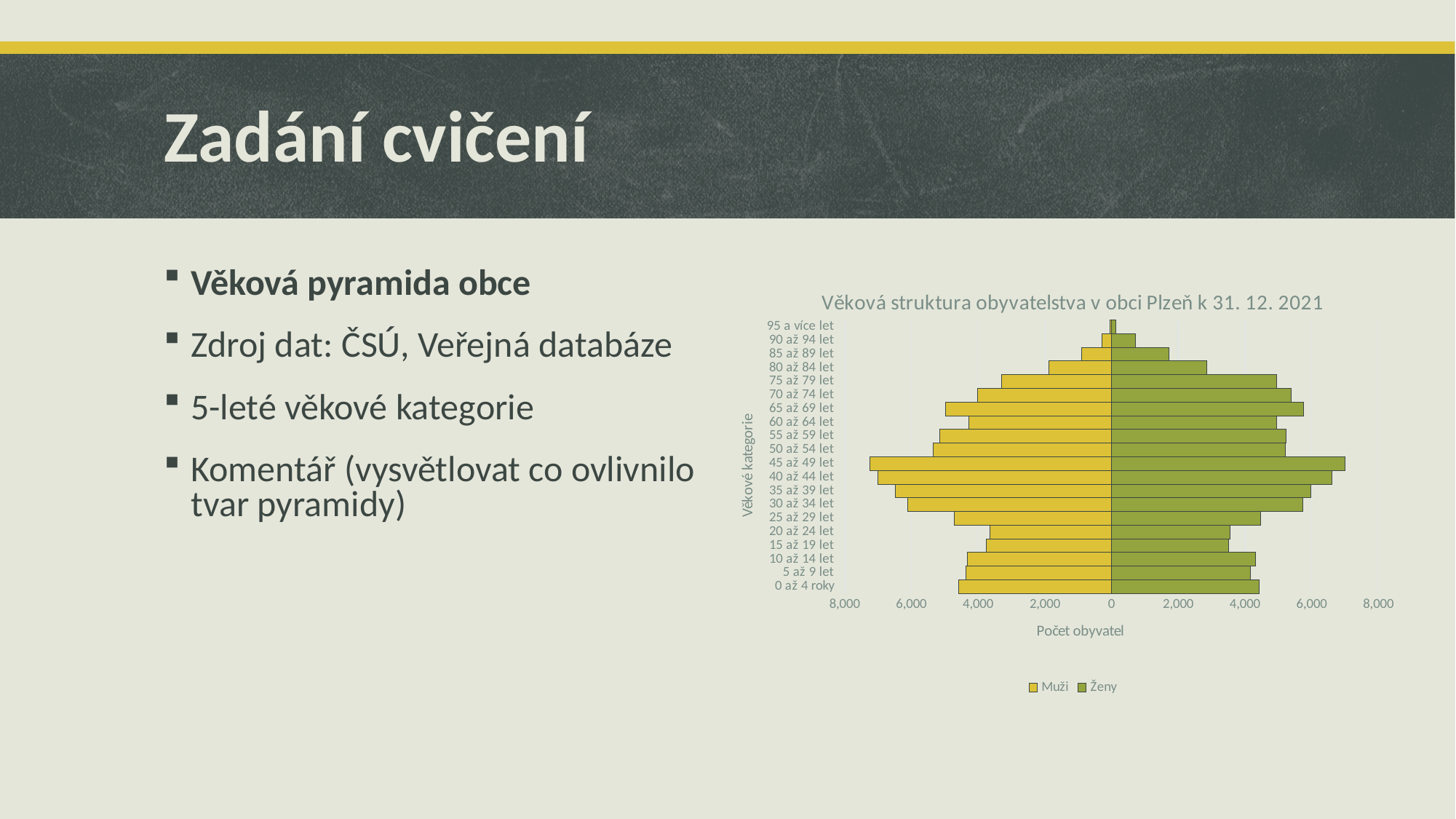
Is the value for Ženy in the 85 až 89 let category greater or less than 2,000? less Is the value for Muži in the 45 až 49 let category greater or less than 6,000? greater Is the value for Muži in the 20 až 24 let category greater or less than 4,000? less How many series does the chart legend list? 2 Which age category has the longest bar for Muži? 45 až 49 let Which age category has the shortest bar for Ženy? 95 a více let What kind of chart is shown on the slide? bar chart How many age categories are shown on the vertical axis of the chart? 20 What is the title of the chart? Věková struktura obyvatelstva v obci Plzeň k 31. 12. 2021 In the 75 až 79 let category, which series has the larger value, Muži or Ženy? Ženy What is the label of the horizontal axis of the chart? Počet obyvatel